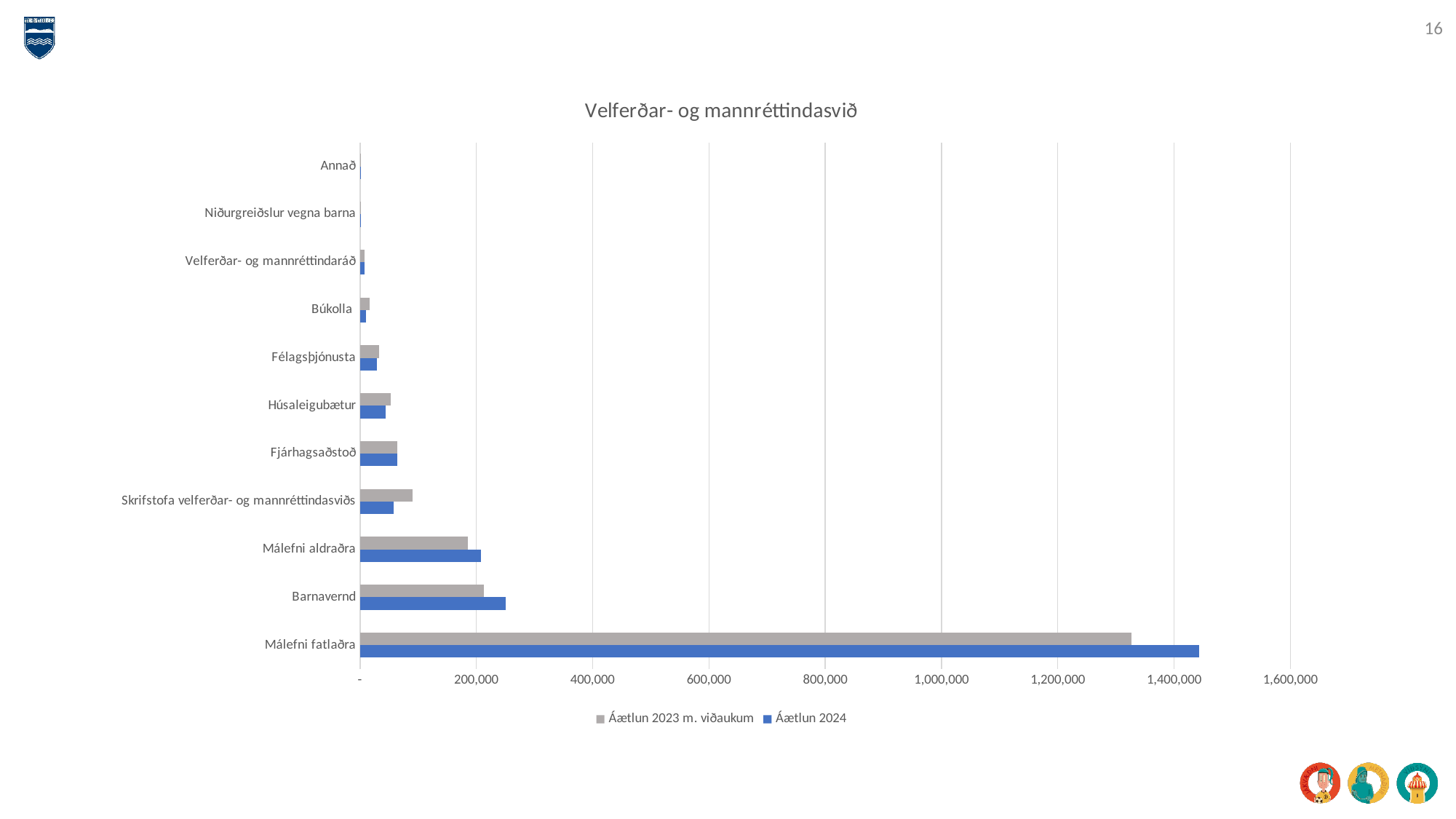
What kind of chart is shown on the slide? Bar chart Is the Áætlun 2024 value for Málefni fatlaðra greater or less than 1,400,000? greater Is the Áætlun 2024 value for Barnavernd greater or less than 200,000? greater What is the title of the chart? Velferðar- og mannréttindasvið Is the Áætlun 2023 m. viðaukum value for Málefni fatlaðra greater or less than 1,400,000? less For Skrifstofa velferðar- og mannréttindasviðs, which series has the larger value: Áætlun 2023 m. viðaukum or Áætlun 2024? Áætlun 2023 m. viðaukum Which category has the highest value for Áætlun 2023 m. viðaukum? Málefni fatlaðra How many categories are shown on the vertical axis of the chart? 11 Which category has the highest value for Áætlun 2024? Málefni fatlaðra How many series does the legend list? 2 For Barnavernd, which series has the larger value: Áætlun 2023 m. viðaukum or Áætlun 2024? Áætlun 2024